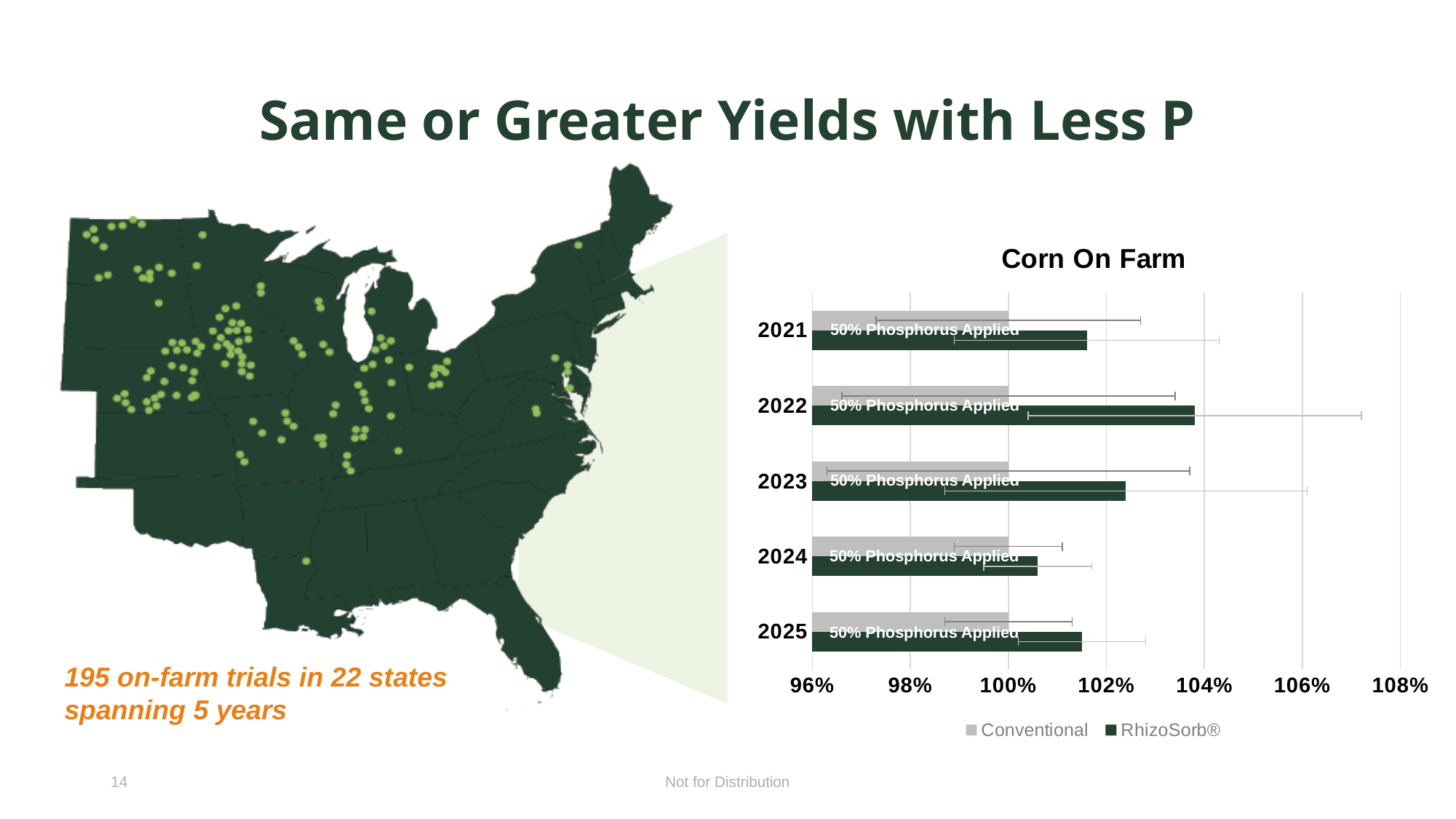
Which year has the highest RhizoSorb® value? 2022 How many series does the chart's legend list? 2 Is the RhizoSorb® value for 2023 greater or less than 102%? greater What value does the Conventional bar reach for 2021? 100% What is the title of the chart? Corn On Farm How many years (categories) are plotted in the chart? 5 What kind of chart is shown on the slide? Bar chart Which is larger, the RhizoSorb® value for 2022 or for 2024? 2022 Which year has the lowest RhizoSorb® value? 2024 Is the RhizoSorb® value for 2022 greater or less than 102%? greater What text label is printed on the RhizoSorb® bars? 50% Phosphorus Applied Is the RhizoSorb® value for 2024 greater or less than 102%? less